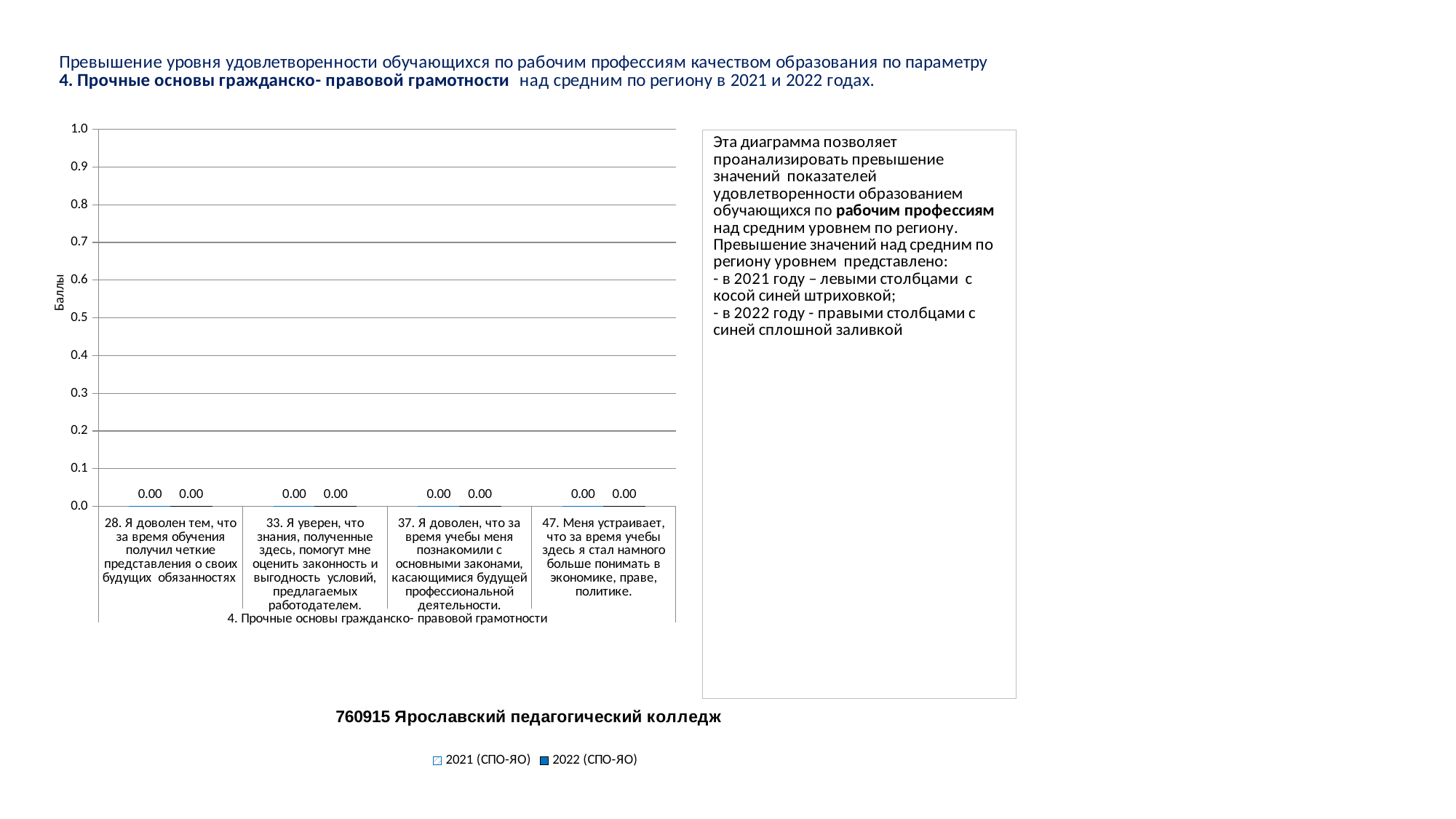
What is the value for 2021 (СПО-ЯО) for category 33 ("Я уверен, что знания, полученные здесь, помогут мне оценить законность и выгодность условий, предлагаемых работодателем")? 0.00 How many series does the legend list? 2 What is the difference between the 2021 (СПО-ЯО) and 2022 (СПО-ЯО) values for category 28? 0.00 Is the value for 2022 (СПО-ЯО) for category 33 greater or less than 0.5? less What is the value for 2021 (СПО-ЯО) for category 28 ("Я доволен тем, что за время обучения получил четкие представления о своих будущих обязанностях")? 0.00 What are the two series named in the legend? 2021 (СПО-ЯО) and 2022 (СПО-ЯО) What is the value for 2022 (СПО-ЯО) for category 47 ("Меня устраивает, что за время учебы здесь я стал намного больше понимать в экономике, праве, политике")? 0.00 What is the highest value shown on the vertical axis? 1.0 How many categories are shown on the x axis of the chart? 4 What kind of chart is shown on the slide? bar chart What is the label of the vertical axis? Баллы What is the value for 2022 (СПО-ЯО) for category 37 ("Я доволен, что за время учебы меня познакомили с основными законами, касающимися будущей профессиональной деятельности")? 0.00